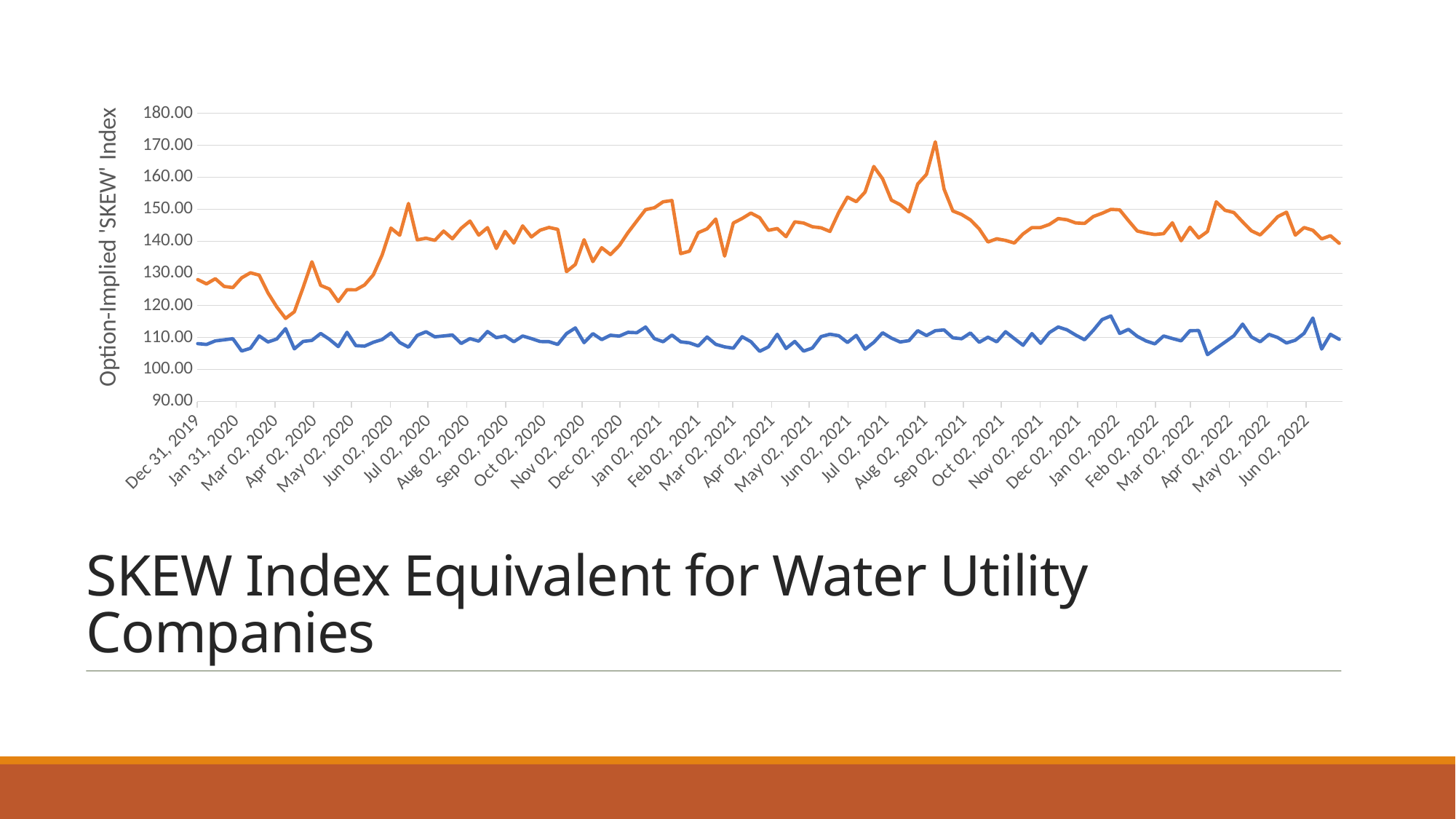
How many data series (lines) are plotted on the chart? 2 Is the value of the orange line at Apr 02, 2020 greater or less than 120? greater Which line is higher throughout the chart, the orange line or the blue line? the orange line Is the value of the blue line at Jan 02, 2022 greater or less than 110? greater What is the first date label on the horizontal axis? Dec 31, 2019 Is the peak value of the orange line greater or less than 160? greater What is the label on the vertical axis of the chart? Option-Implied 'SKEW' Index What type of chart is shown on the slide? line chart Around which month does the orange line reach its highest point? between Aug 02, 2021 and Sep 02, 2021 Around which month does the orange line reach its lowest point? between Mar 02, 2020 and Apr 02, 2020